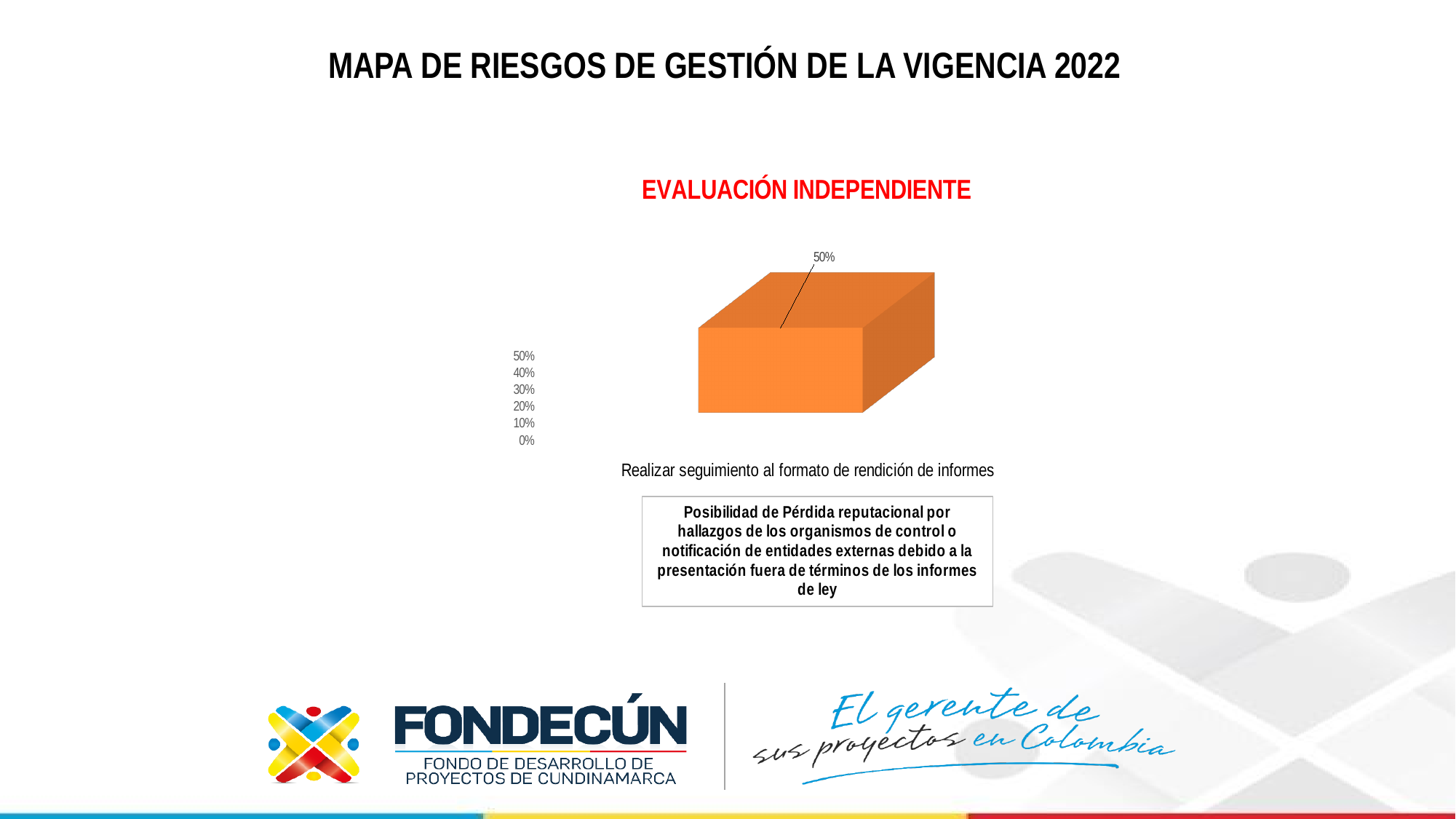
Is the value for "Realizar seguimiento al formato de rendición de informes" greater or less than 10%? greater What is the value shown for "Realizar seguimiento al formato de rendición de informes"? 50% What is the category label shown below the bar? Realizar seguimiento al formato de rendición de informes What is the title of the chart? EVALUACIÓN INDEPENDIENTE What kind of chart is shown on the slide? bar chart Is the value for "Realizar seguimiento al formato de rendición de informes" greater or less than 40%? greater What is the highest value shown on the chart's vertical axis? 50% How many bars are plotted in the chart? 1